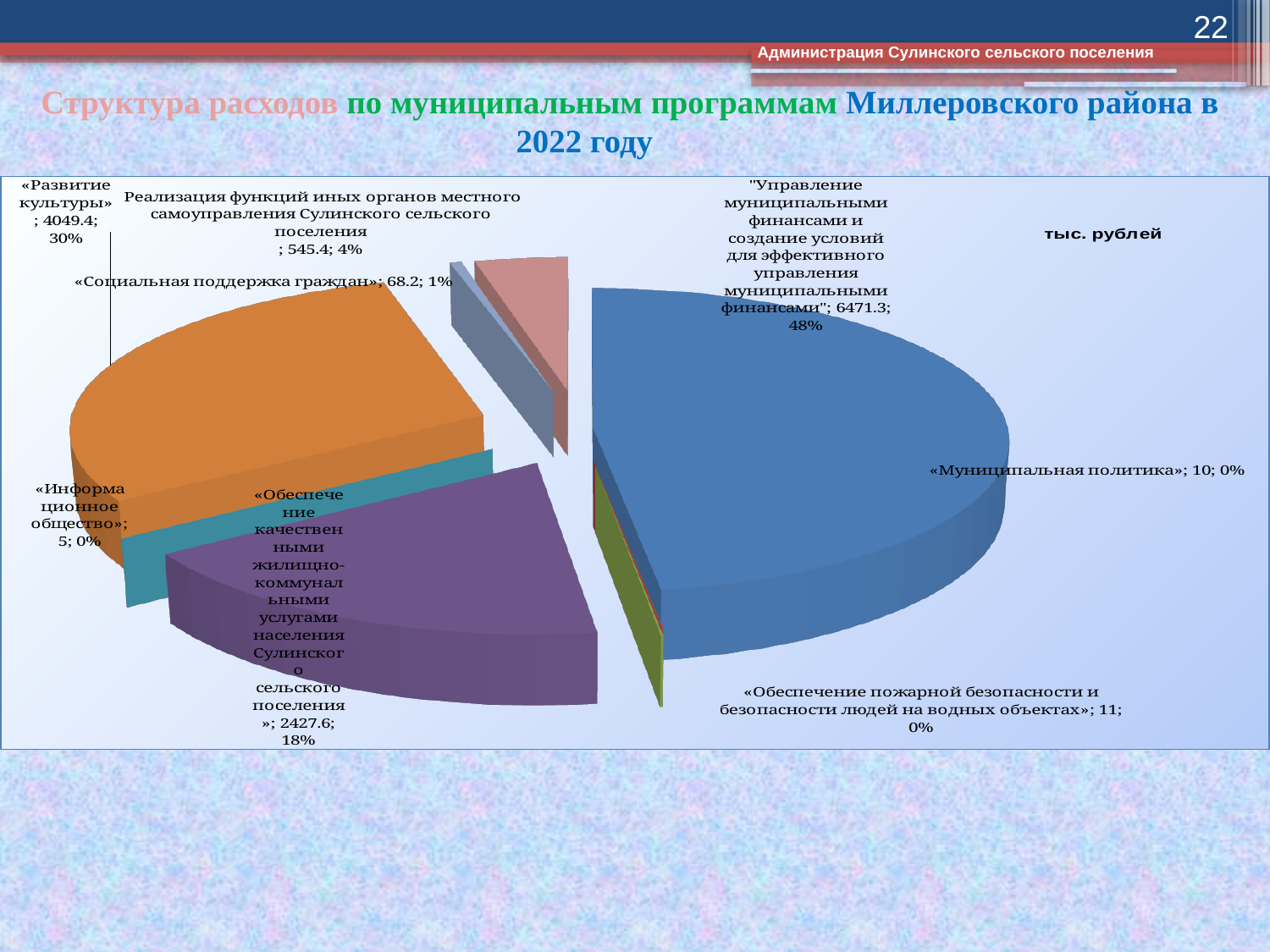
Which is larger: the value for «Обеспечение пожарной безопасности и безопасности людей на водных объектах» or for «Муниципальная политика»? «Обеспечение пожарной безопасности и безопасности людей на водных объектах» In what units are the chart values given, according to the label on the chart? тыс. рублей What is the value for «Развитие культуры»? 4049.4 What is the difference between the values for "Управление муниципальными финансами..." (6471.3) and «Развитие культуры» (4049.4)? 2421.9 What share of the pie does «Развитие культуры» represent? 30% What share of the pie does «Обеспечение качественными жилищно-коммунальными услугами населения Сулинского сельского поселения» represent? 18% What kind of chart is shown on the slide? pie chart Which category has the smallest value? «Информационное общество» What is the value for «Муниципальная политика»? 10 Which category has the largest slice of the pie? "Управление муниципальными финансами и создание условий для эффективного управления муниципальными финансами" What is the value for «Социальная поддержка граждан»? 68.2 How many slices (categories) does the pie chart have? 8